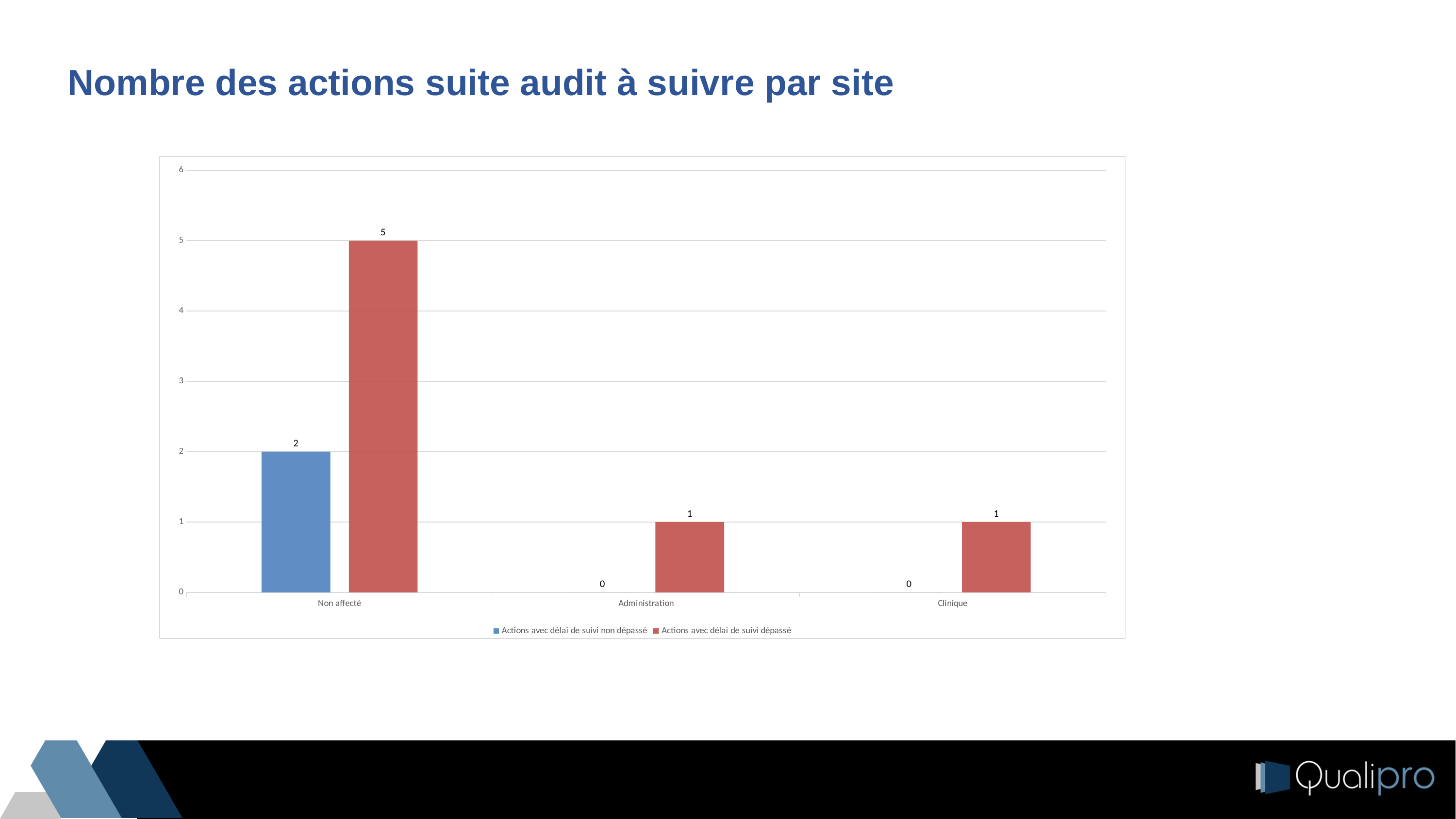
How many sites are shown on the x axis? 3 What is the value of 'Actions avec délai de suivi non dépassé' for Clinique? 0 What is the value of 'Actions avec délai de suivi non dépassé' for Non affecté? 2 Which colour represents 'Actions avec délai de suivi dépassé' in the legend? Red For Administration, which is larger: 'Actions avec délai de suivi dépassé' or 'Actions avec délai de suivi non dépassé'? Actions avec délai de suivi dépassé What kind of chart is shown on the slide? Bar chart What is the value of 'Actions avec délai de suivi dépassé' for Non affecté? 5 How many series does the legend list? 2 Which site has the highest value for 'Actions avec délai de suivi dépassé'? Non affecté What is the difference between 'Actions avec délai de suivi dépassé' and 'Actions avec délai de suivi non dépassé' for Non affecté? 3 What is the title of the slide? Nombre des actions suite audit à suivre par site What is the value of 'Actions avec délai de suivi dépassé' for Administration? 1